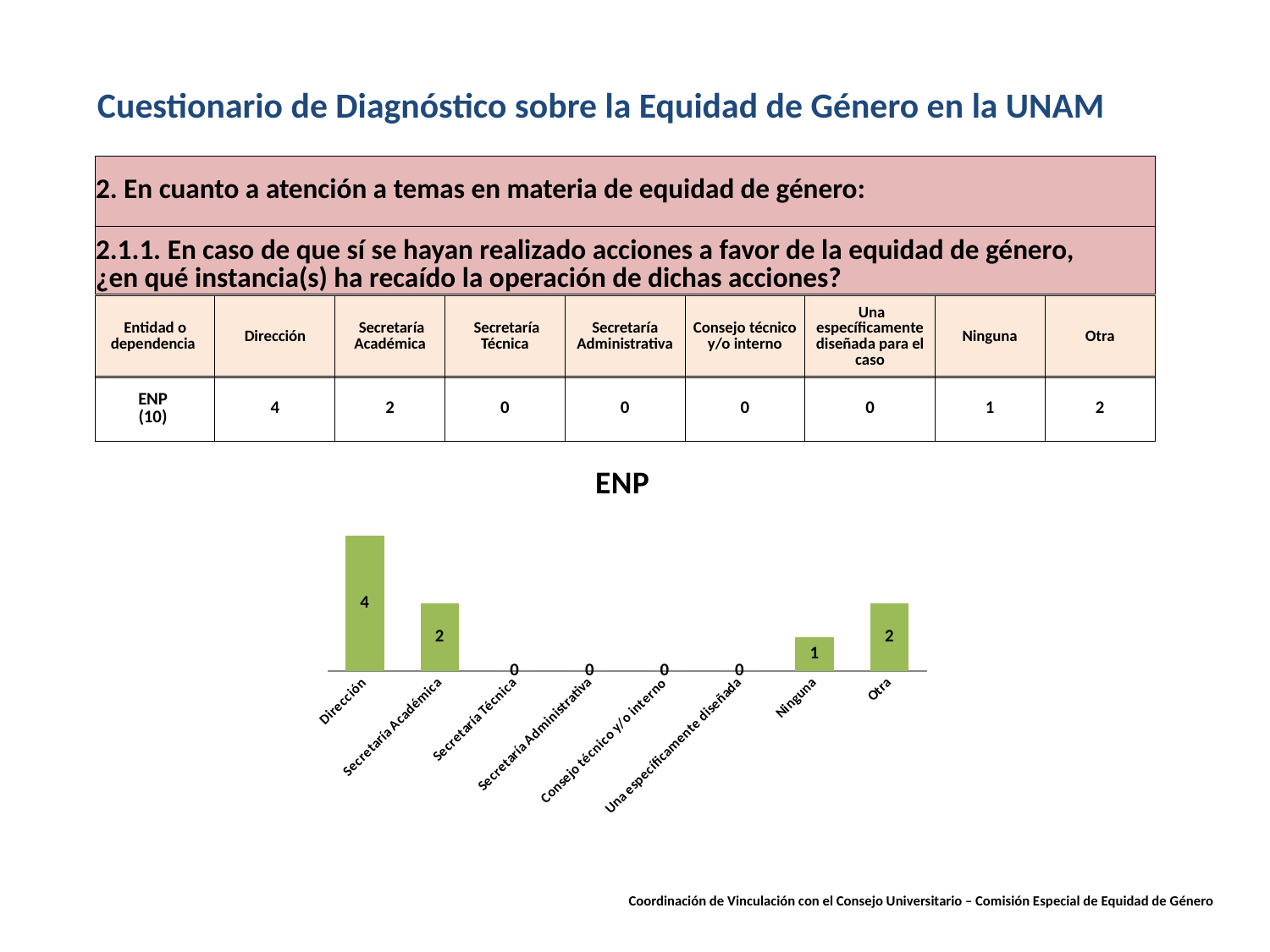
Which is larger in the ENP chart, the value for Ninguna or the value for Otra? Otra What is the value for Dirección in the ENP chart? 4 How many categories are shown on the x axis of the ENP chart? 8 What is the title of the chart on the slide? ENP What is the value for Otra in the ENP chart? 2 What kind of chart is the ENP chart? Bar chart How many categories in the ENP chart have a value of 0? 4 What is the value for Ninguna in the ENP chart? 1 Which category has the highest value in the ENP chart? Dirección What is the value for Secretaría Académica in the ENP chart? 2 What is the difference between the values for Dirección and Secretaría Académica in the ENP chart? 2 What is the value for Secretaría Técnica in the ENP chart? 0